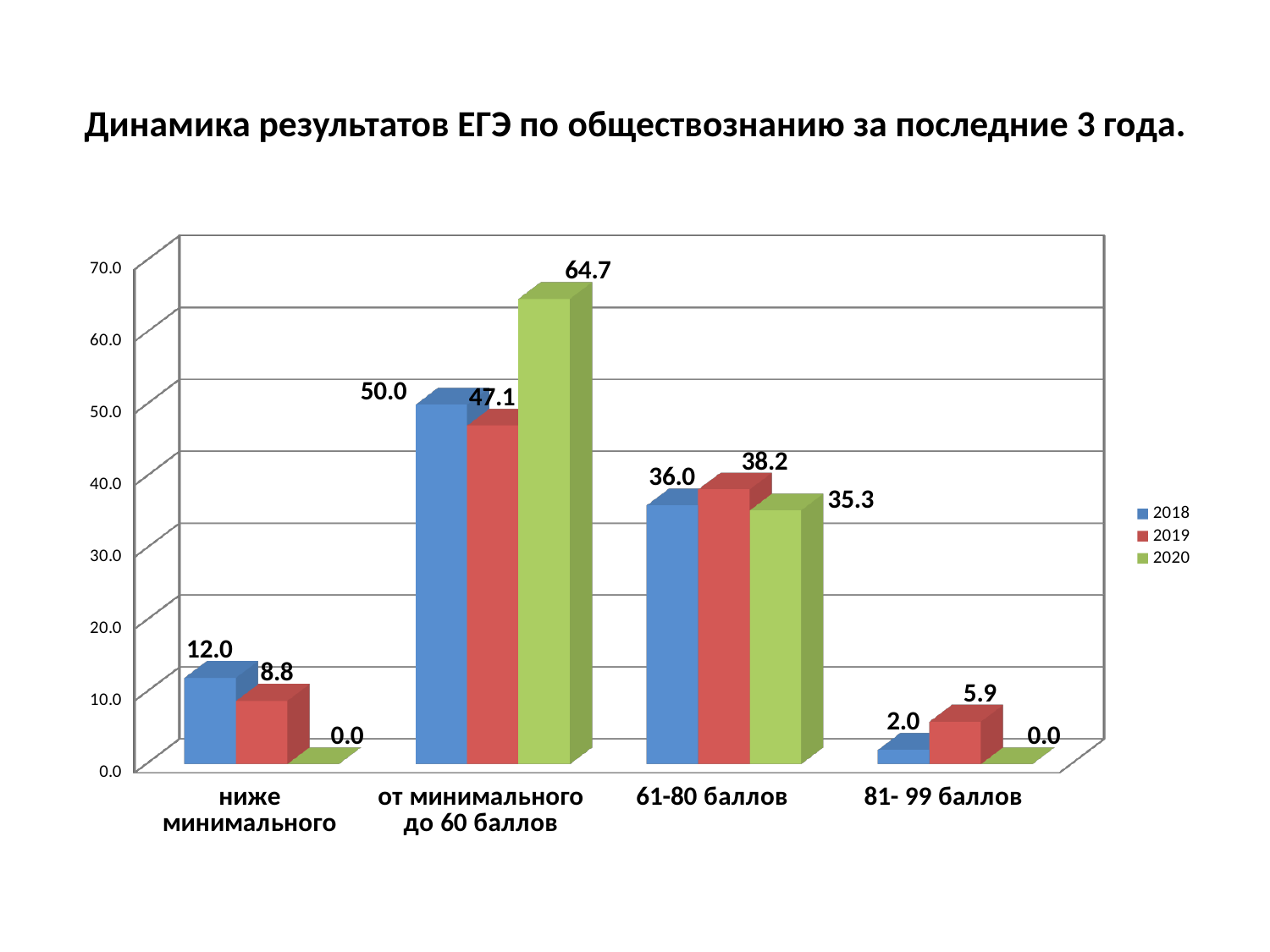
What is the value for 2018 in the category "ниже минимального"? 12.0 Which category has the lowest value for the 2018 series? 81- 99 баллов What is the value for 2019 in the category "81- 99 баллов"? 5.9 What is the difference between the 2020 and 2018 values in the category "от минимального до 60 баллов"? 14.7 In the category "61-80 баллов", which series has the larger value, 2018 or 2019? 2019 Which colour represents the 2020 series in the legend? green What is the title of the chart? Динамика результатов ЕГЭ по обществознанию за последние 3 года. What is the value for 2020 in the category "от минимального до 60 баллов"? 64.7 What kind of chart is shown on the slide? bar chart Which category has the highest value for the 2019 series? от минимального до 60 баллов How many series does the legend list? 3 How many categories are shown on the x axis? 4